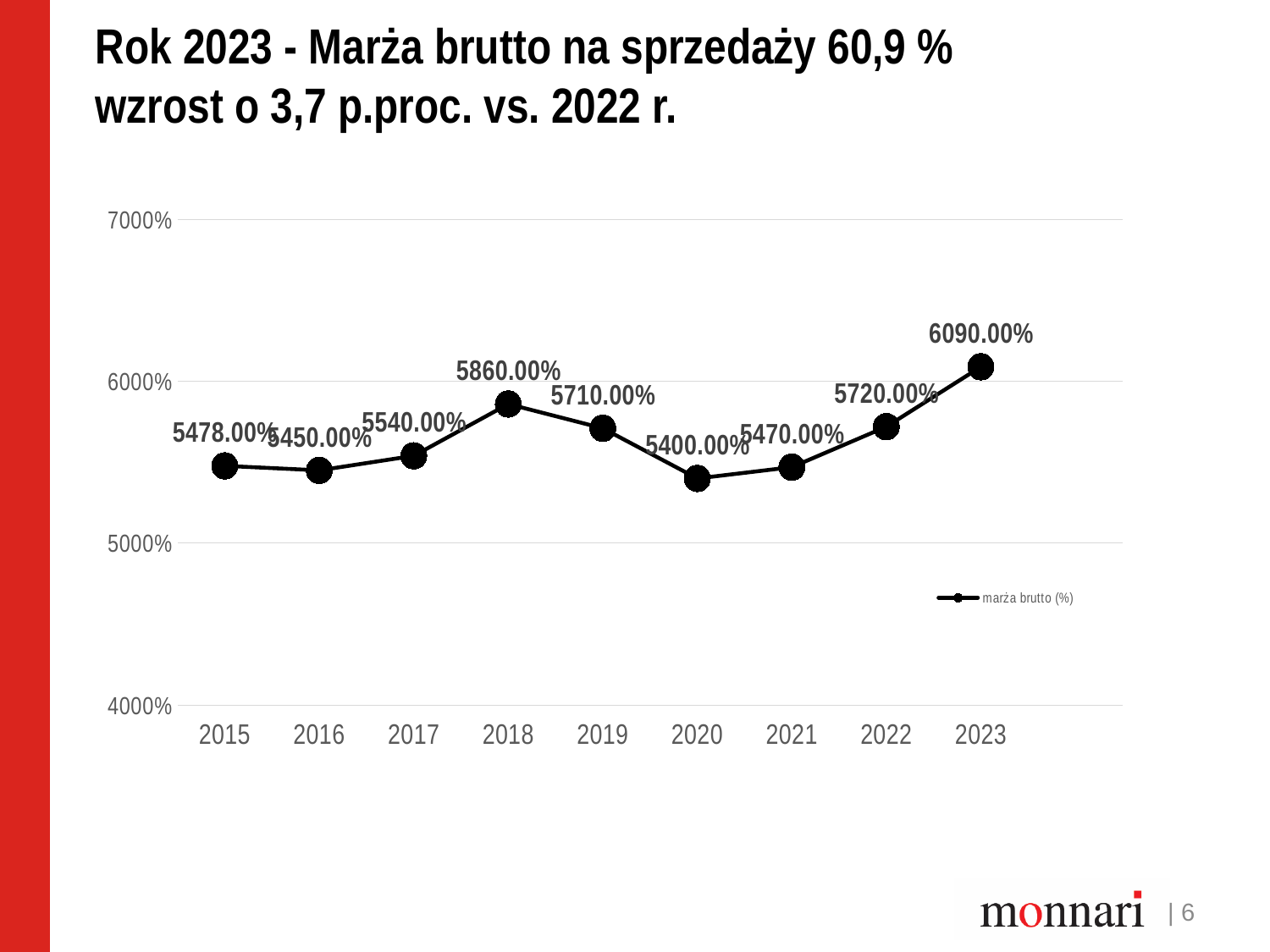
What type of chart is shown on the slide? line chart Which year has the highest value? 2023 Which year has the lowest value? 2020 What is the value for 2018? 5860.00% What is the difference between the values for 2023 and 2022? 370.00% How many series does the legend list? 1 Which is larger, the value for 2018 or the value for 2019? 2018 What is the legend entry for the plotted series? marża brutto (%) What is the value for 2015? 5478.00% What is the value for 2020? 5400.00% What is the value for 2023? 6090.00% How many years are plotted on the x axis? 9